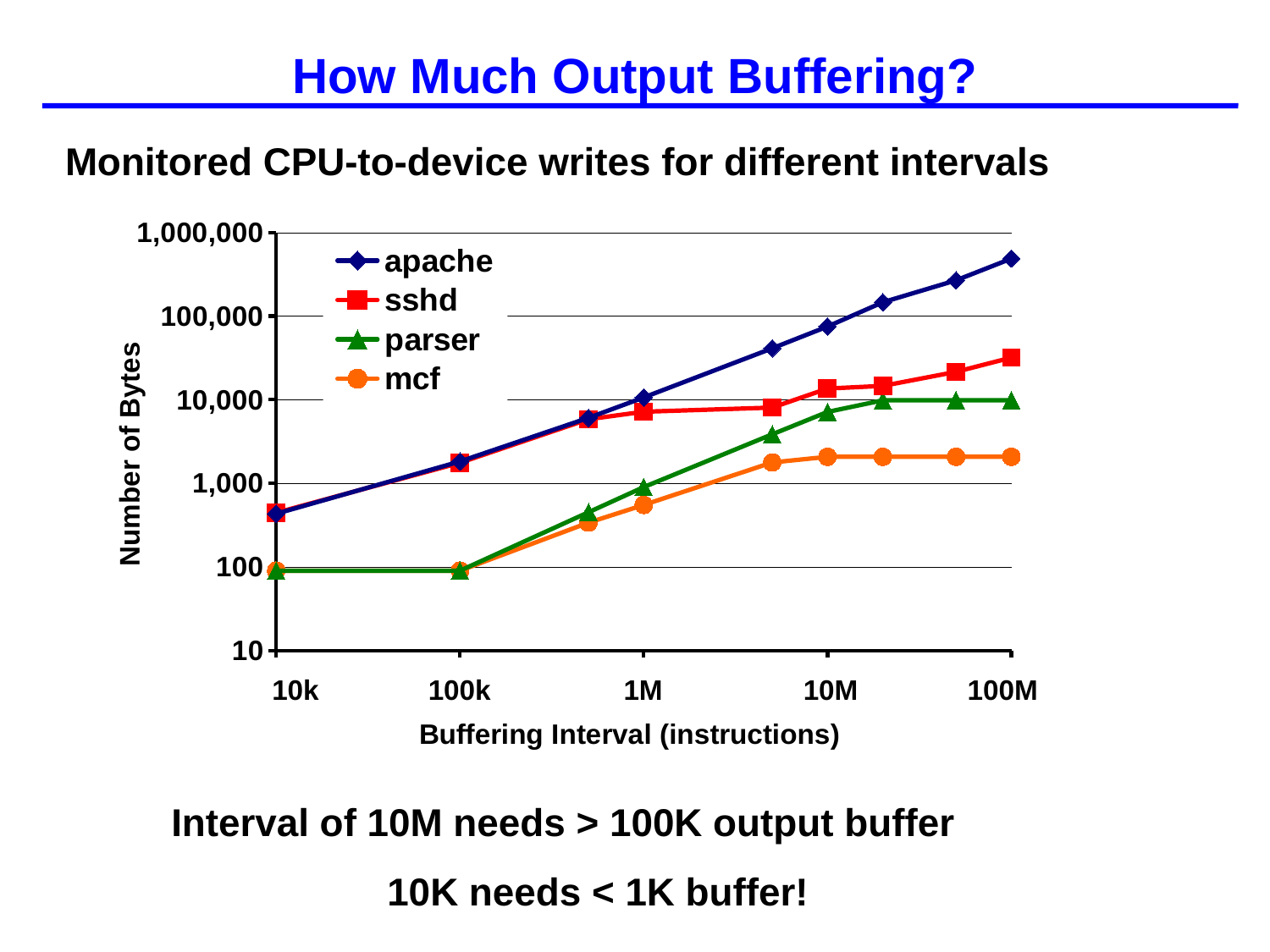
Is the value for sshd at 100M greater or less than 10,000? greater Is the value for apache at 100M greater or less than 100,000? greater At a buffering interval of 10M, which is larger, apache or sshd? apache How many series does the legend list? 4 What is the label of the y axis? Number of Bytes Which series has the lowest number of bytes at a buffering interval of 100M? mcf Which series has the highest number of bytes at a buffering interval of 100M? apache Does the apache series rise or fall as the buffering interval increases? rises What kind of chart is shown on the slide? line chart At a buffering interval of 100M, which is larger, sshd or parser? sshd Is the value for apache at 10k greater or less than 1,000? less